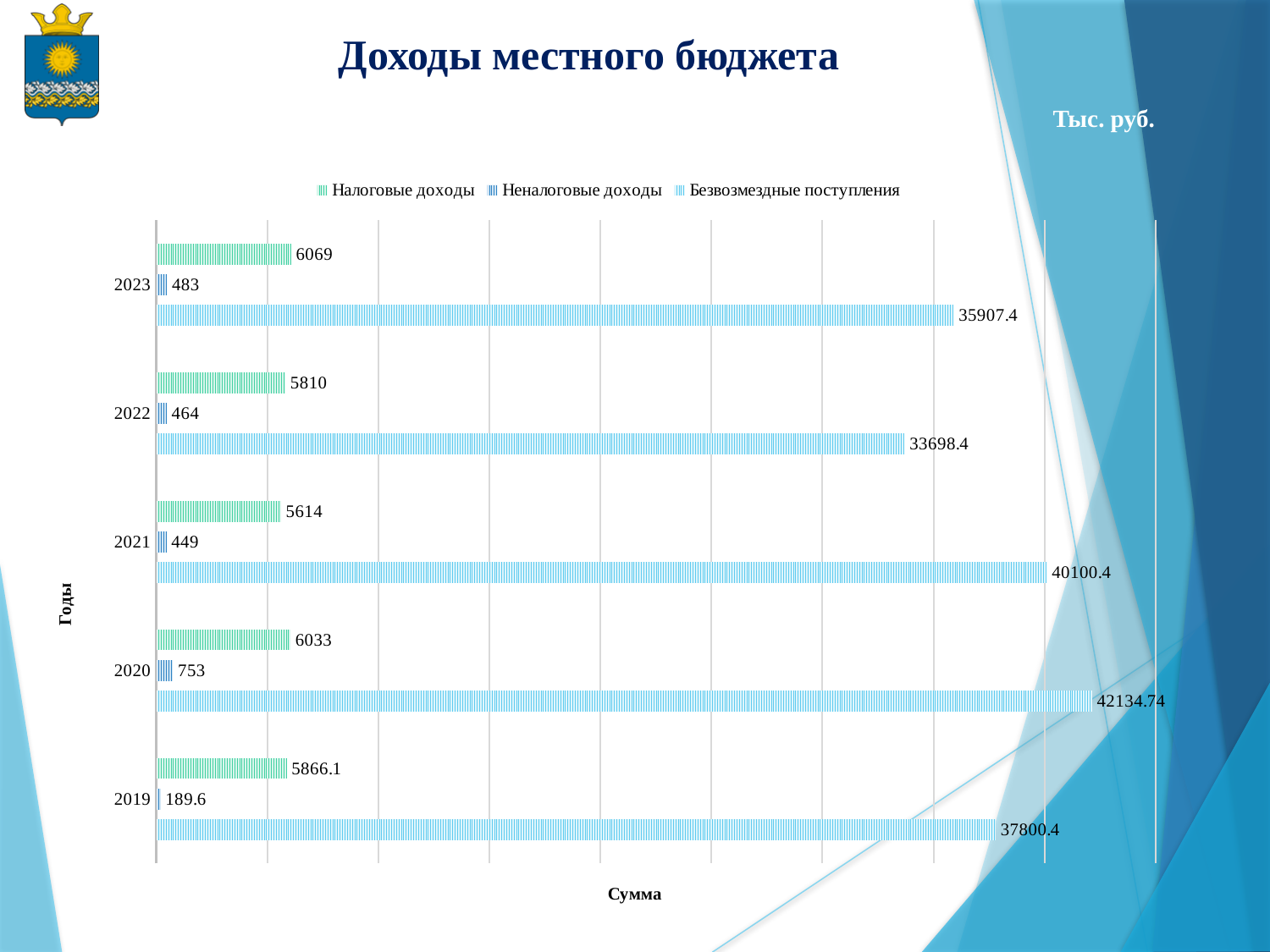
Which year has the highest value of Безвозмездные поступления? 2020 How many years are shown on the chart? 5 What is the difference between Налоговые доходы in 2023 and in 2022? 259 What is the title of the chart? Доходы местного бюджета How many series does the legend list? 3 Which year has the lowest value of Неналоговые доходы? 2019 Which is larger: Безвозмездные поступления in 2021 or in 2019? 2021 What is the difference between Неналоговые доходы in 2020 and in 2021? 304 What is the value of Безвозмездные поступления for 2020? 42134.74 What is the value of Налоговые доходы for 2023? 6069 What is the value of Неналоговые доходы for 2019? 189.6 What kind of chart is shown on the slide? Bar chart